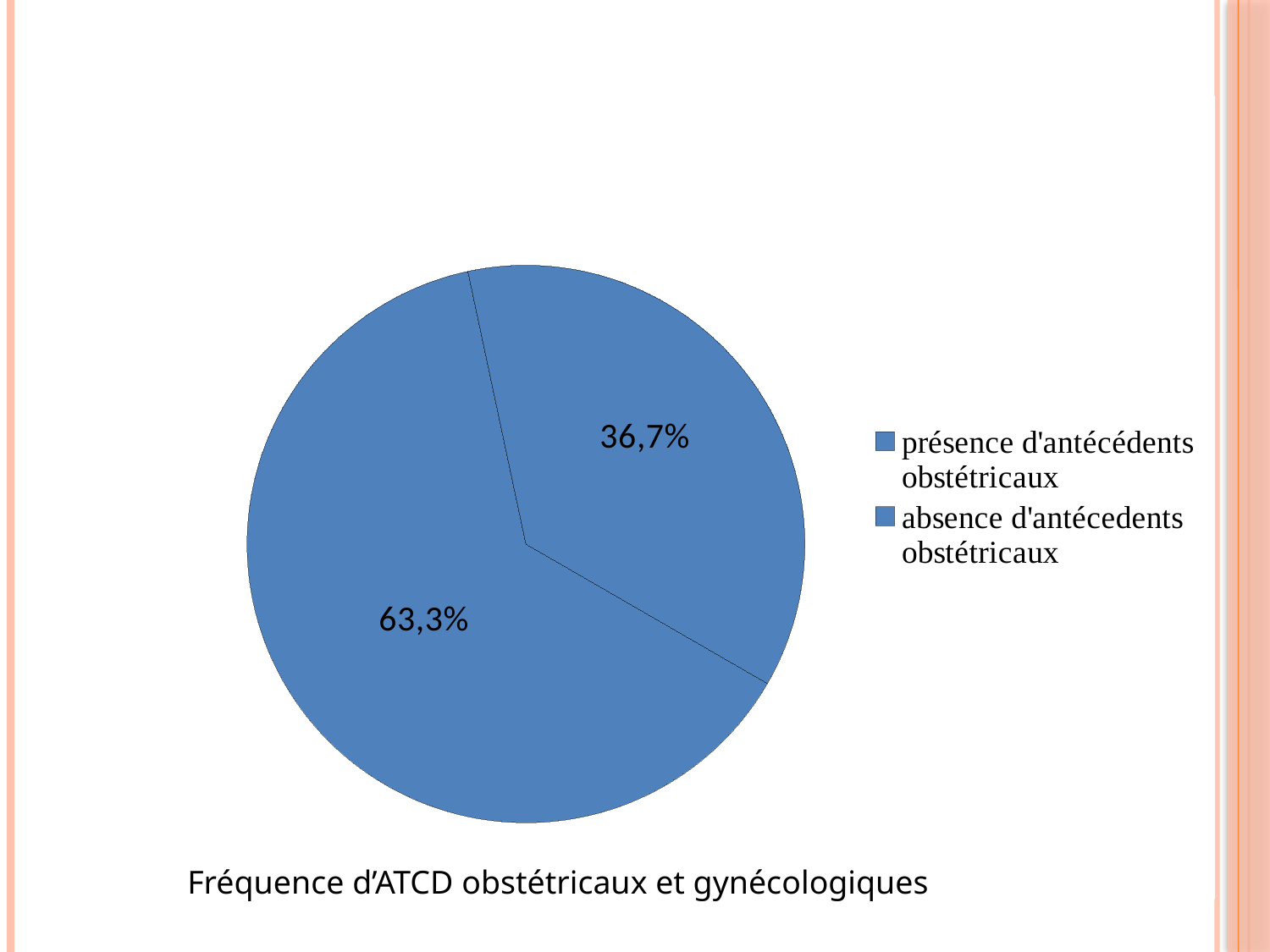
How many slices does the pie chart have? 2 How many entries does the legend of the pie chart list? 2 What is the percentage shown on the smallest slice of the pie chart? 36,7% What is the caption written below the pie chart? Fréquence d'ATCD obstétricaux et gynécologiques What is the percentage shown on the largest slice of the pie chart? 63,3% Is the slice labelled 63,3% larger or smaller than the slice labelled 36,7%? larger What is the difference between the two slice percentages shown on the pie chart? 26,6% What is the first entry listed in the legend of the pie chart? présence d'antécédents obstétricaux Is the smaller slice of the pie chart greater or less than 50%? less What kind of chart is shown on the slide? pie chart